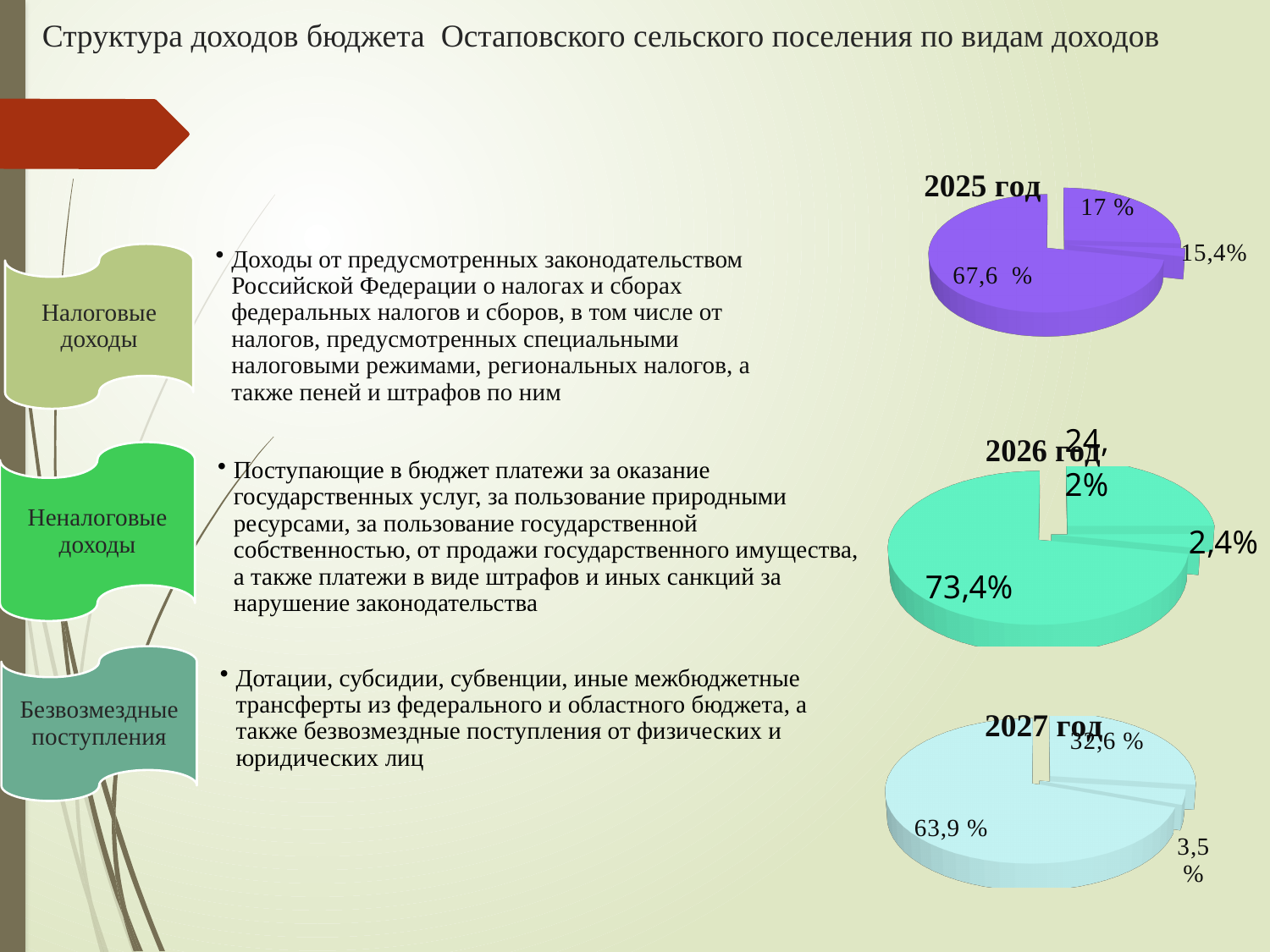
In the 2026 год pie chart, what is the value of the smallest slice? 2,4% How many pie charts are shown on the slide? 3 In the 2025 год pie chart, what is the value of the smallest slice? 15,4% In the 2026 год pie chart, what is the value of the largest slice? 73,4% In the 2027 год pie chart, what is the value of the smallest slice? 3,5 % In the 2025 год pie chart, what is the value of the largest slice? 67,6 % What kind of chart is used for the 2025 год chart? pie chart In the 2025 год pie chart, what is the difference between the largest slice (67,6 %) and the slice labelled 17 %? 50,6 % How many slices does the 2025 год pie chart have? 3 How many slices does the 2026 год pie chart have? 3 In the 2027 год pie chart, what is the value of the largest slice? 63,9 % In the 2027 год pie chart, what is the difference between the slices labelled 63,9 % and 32,6 %? 31,3 %